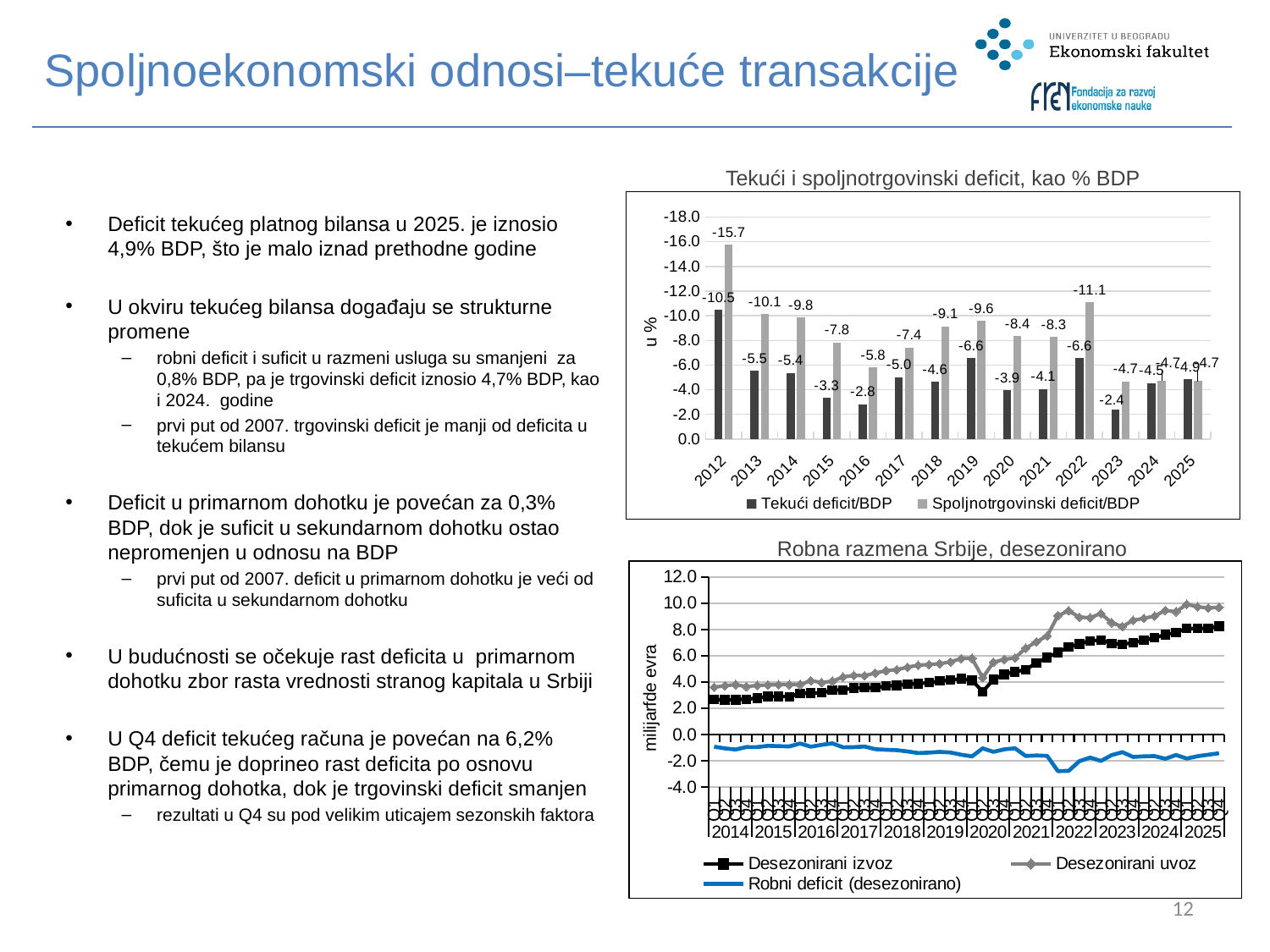
In the chart 'Robna razmena Srbije, desezonirano', is the value of Desezonirani uvoz in Q4 2025 greater or less than 8.0? greater In the chart 'Tekući i spoljnotrgovinski deficit, kao % BDP', which is larger in absolute terms in 2025: Tekući deficit/BDP or Spoljnotrgovinski deficit/BDP? Tekući deficit/BDP In the chart 'Tekući i spoljnotrgovinski deficit, kao % BDP', which year has the smallest Tekući deficit/BDP (the shortest dark bar)? 2023 What kind of chart is 'Robna razmena Srbije, desezonirano'? Line chart In the chart 'Tekući i spoljnotrgovinski deficit, kao % BDP', what is the value of Spoljnotrgovinski deficit/BDP for 2022? -11.1 How many series does the legend of the chart 'Robna razmena Srbije, desezonirano' list? 3 In the chart 'Tekući i spoljnotrgovinski deficit, kao % BDP', which year has the largest Spoljnotrgovinski deficit/BDP (the longest grey bar)? 2012 How many years are shown on the x axis of the chart 'Tekući i spoljnotrgovinski deficit, kao % BDP'? 14 How many series does the legend of the chart 'Tekući i spoljnotrgovinski deficit, kao % BDP' list? 2 In the chart 'Tekući i spoljnotrgovinski deficit, kao % BDP', what is the value of Tekući deficit/BDP for 2025? -4.9 In the chart 'Tekući i spoljnotrgovinski deficit, kao % BDP', what is the value of Spoljnotrgovinski deficit/BDP for 2012? -15.7 In the chart 'Tekući i spoljnotrgovinski deficit, kao % BDP', what is the difference between the Spoljnotrgovinski deficit/BDP and the Tekući deficit/BDP in 2012, in percentage points? 5.2